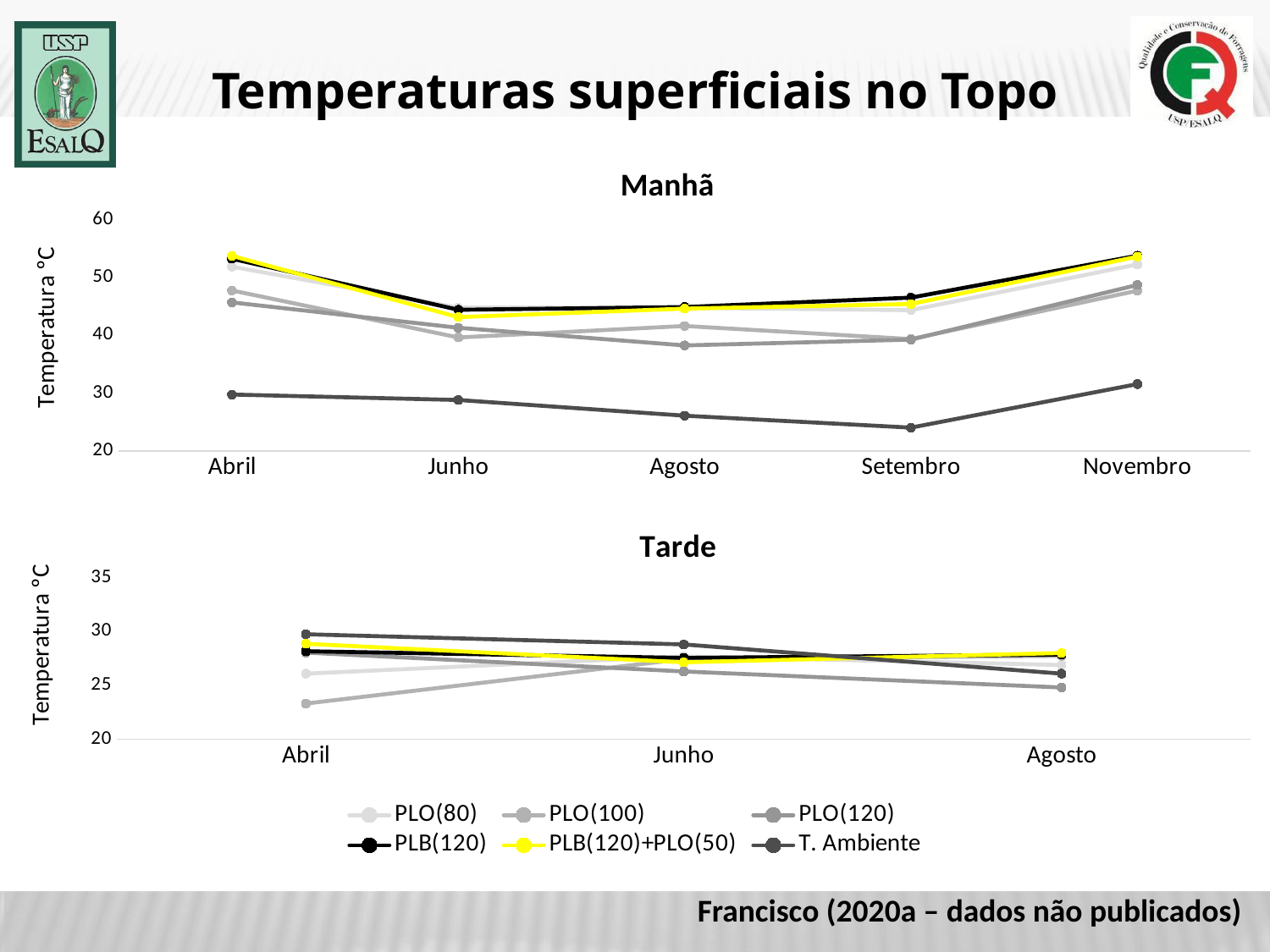
In the "Manhã" chart, is the value for T. Ambiente in Setembro greater or less than 30? less How many series does the legend list? 6 In the "Manhã" chart, which is larger in Setembro: PLB(120) or PLO(120)? PLB(120) What kind of chart is the "Manhã" chart? line chart Which colour is used for the PLB(120)+PLO(50) series? yellow In the "Manhã" chart, which series has the lowest values across all months? T. Ambiente In the "Tarde" chart, does the T. Ambiente line rise or fall from Abril to Agosto? fall In the "Tarde" chart, which series has the lowest value in Abril? PLO(100) How many months are shown on the x axis of the "Manhã" chart? 5 How many months are shown on the x axis of the "Tarde" chart? 3 In the "Manhã" chart, is the value for PLB(120) in Abril greater or less than 50? greater In the "Tarde" chart, is the value for PLO(100) in Abril greater or less than 25? less